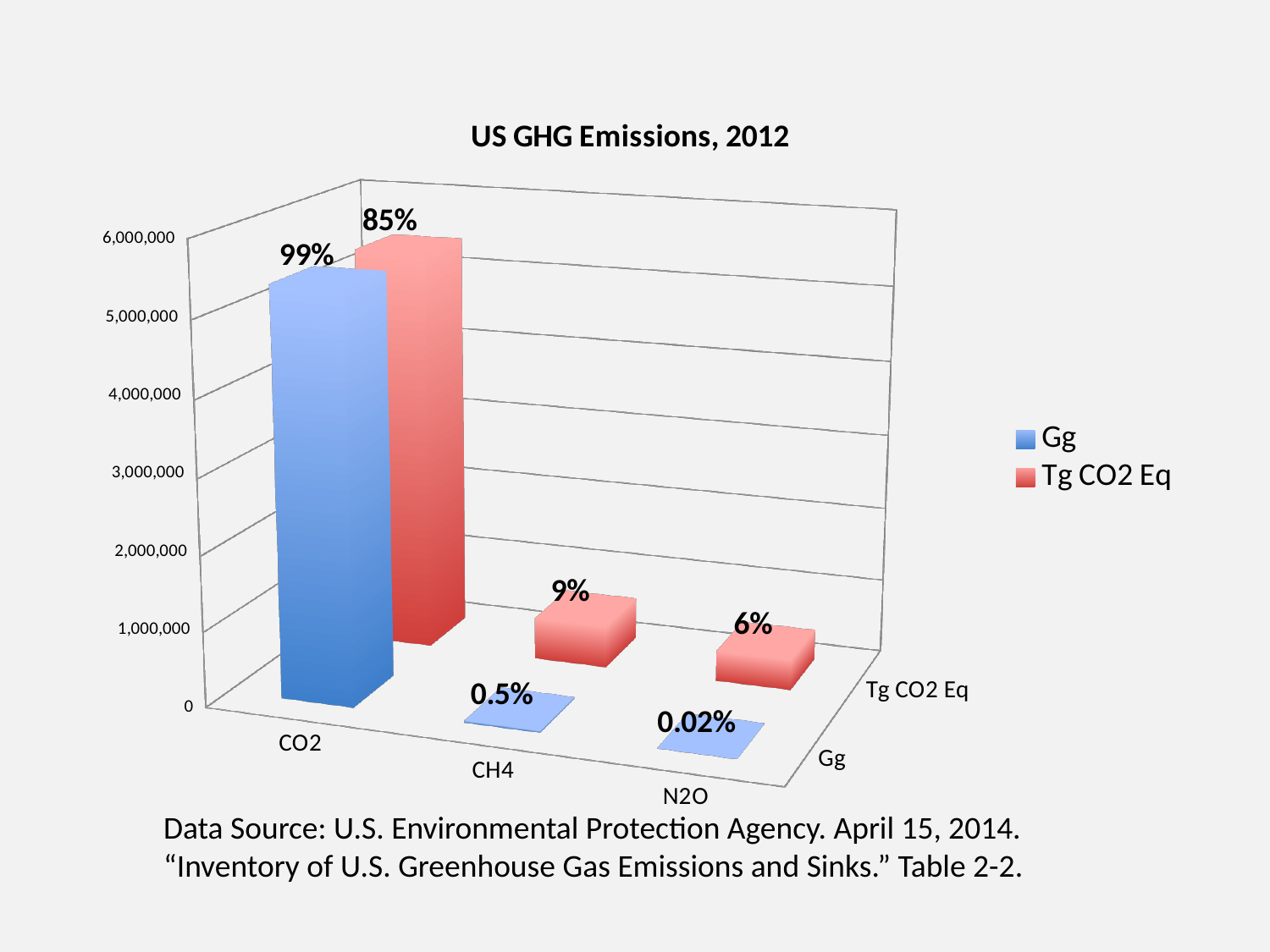
What percentage label is shown on the Tg CO2 Eq bar for CO2? 85% What percentage label is shown on the Gg bar for N2O? 0.02% Which gas has the lowest Tg CO2 Eq bar? N2O What is the title of the chart? US GHG Emissions, 2012 How many gases are shown on the x axis? 3 What is the difference between the Tg CO2 Eq percentage labels for CH4 and N2O? 3% Which gas has the highest Gg bar? CO2 How many series does the legend list? 2 Is the value of the Gg bar for CH4 greater or less than 1,000,000? less What percentage label is shown on the Tg CO2 Eq bar for CH4? 9% What percentage label is shown on the Gg bar for CO2? 99% Which is larger, the Gg percentage label for CH4 or for N2O? CH4